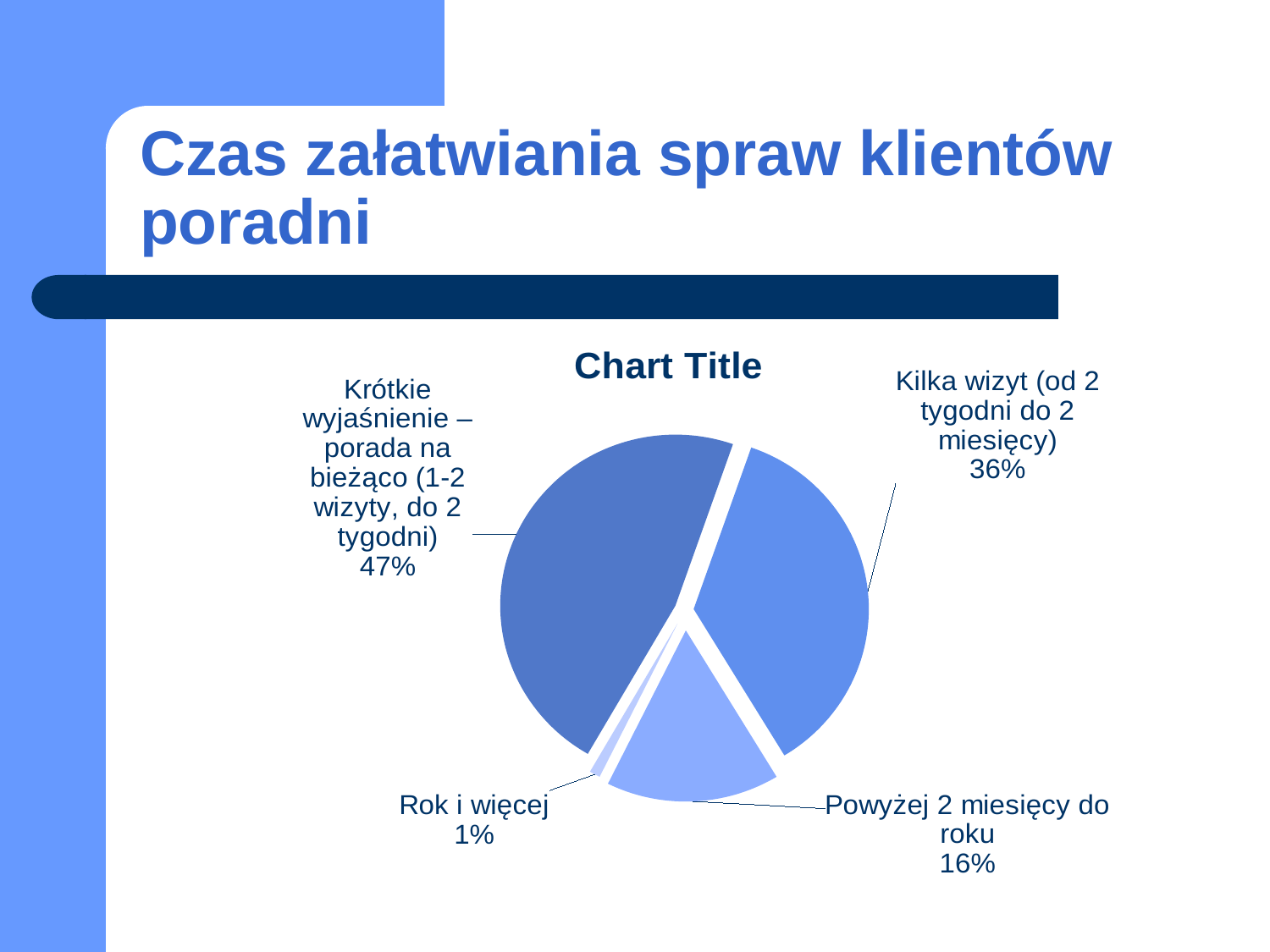
What is the difference in percentage points between "Krótkie wyjaśnienie – porada na bieżąco" and "Kilka wizyt (od 2 tygodni do 2 miesięcy)"? 11 What is the value shown for "Rok i więcej"? 1% What is the value shown for "Krótkie wyjaśnienie – porada na bieżąco (1-2 wizyty, do 2 tygodni)"? 47% What is the difference in percentage points between "Powyżej 2 miesięcy do roku" and "Rok i więcej"? 15 What is the value shown for "Powyżej 2 miesięcy do roku"? 16% Which category has the smallest slice of the pie? Rok i więcej Which category has the largest slice of the pie? Krótkie wyjaśnienie – porada na bieżąco (1-2 wizyty, do 2 tygodni) What share of the pie does "Kilka wizyt (od 2 tygodni do 2 miesięcy)" represent? 36% Which is larger: the slice for "Kilka wizyt (od 2 tygodni do 2 miesięcy)" or the slice for "Powyżej 2 miesięcy do roku"? Kilka wizyt (od 2 tygodni do 2 miesięcy) What is the title printed above the chart? Chart Title How many categories are shown in the pie chart? 4 What kind of chart is shown on the slide? Pie chart